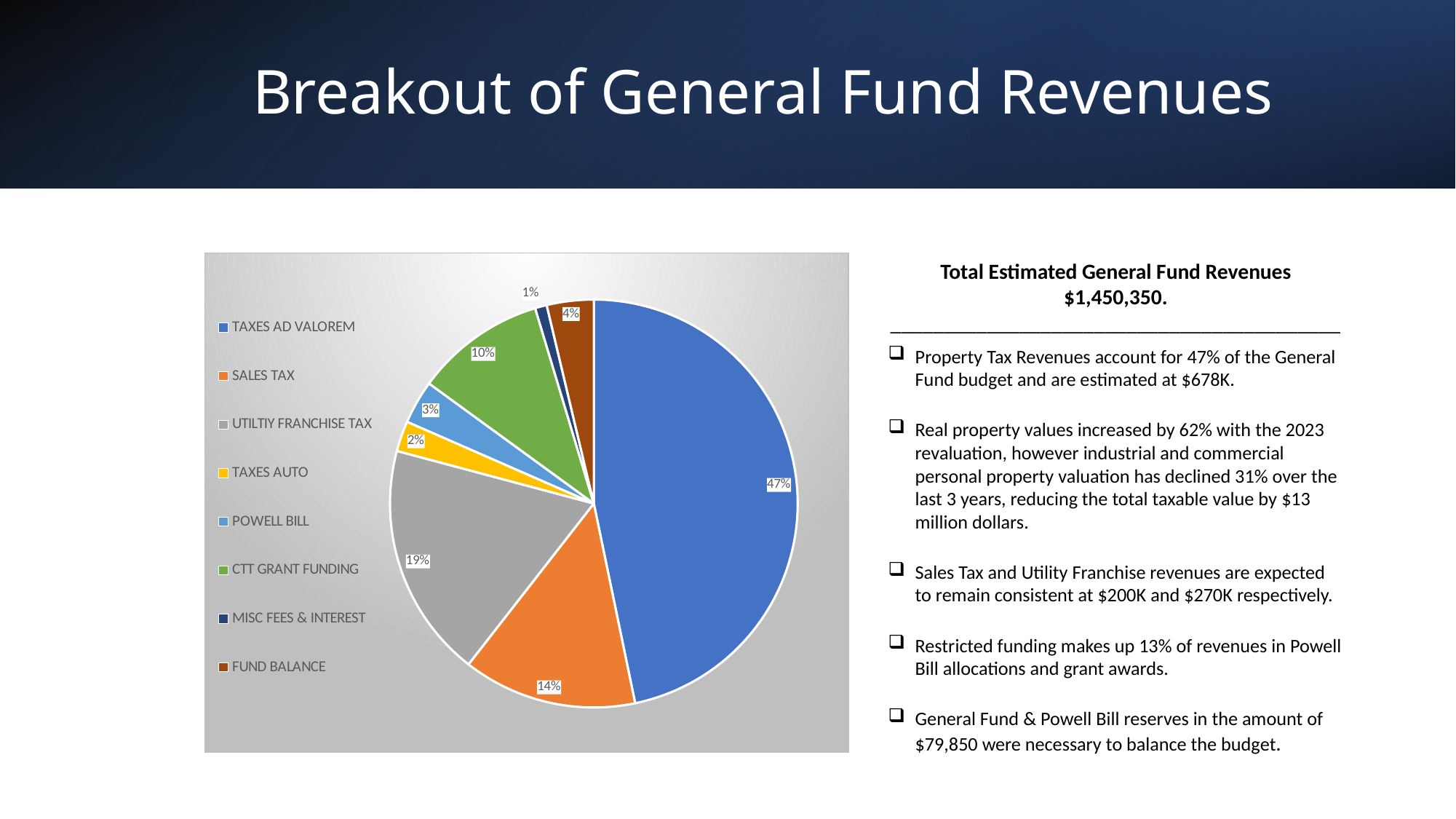
What percentage of the pie is SALES TAX? 14% What colour is the TAXES AUTO slice? Yellow Which is larger, POWELL BILL or TAXES AUTO? POWELL BILL What share of General Fund revenues comes from TAXES AD VALOREM? 47% What percentage of the pie is UTILTIY FRANCHISE TAX? 19% How many categories does the legend list? 8 What share does CTT GRANT FUNDING represent? 10% What is the difference in percentage points between UTILTIY FRANCHISE TAX and SALES TAX? 5 What percentage is shown for FUND BALANCE? 4% Which category has the largest slice of the pie? TAXES AD VALOREM What kind of chart is shown on the slide? Pie chart Which category has the smallest slice of the pie? MISC FEES & INTEREST